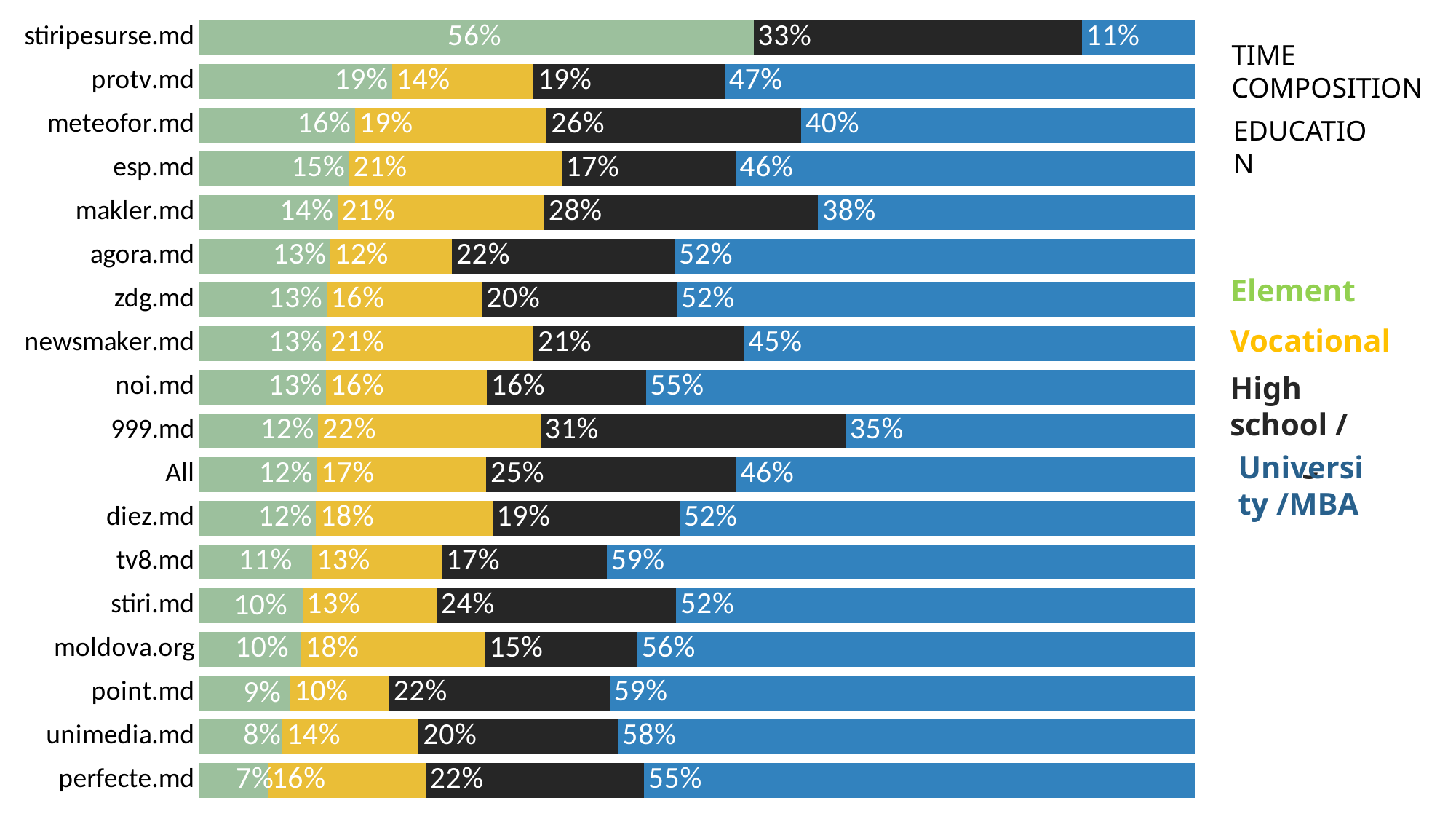
Which category has the lowest Element share? perfecte.md What is the University/MBA value for tv8.md? 59% Which category has the lowest University/MBA share? stiripesurse.md For 999.md, what is the difference between the High school value and the Vocational value? 9 percentage points What is the Vocational value for the 'All' category? 17% How many categories are shown on the y axis of the chart? 18 What kind of chart is shown on the slide? Stacked bar chart How many series does the legend list? 4 Which has a larger University/MBA share, agora.md or makler.md? agora.md What is the High school value for makler.md? 28% Which category has the highest Element share? stiripesurse.md What is the Element value for stiripesurse.md? 56%